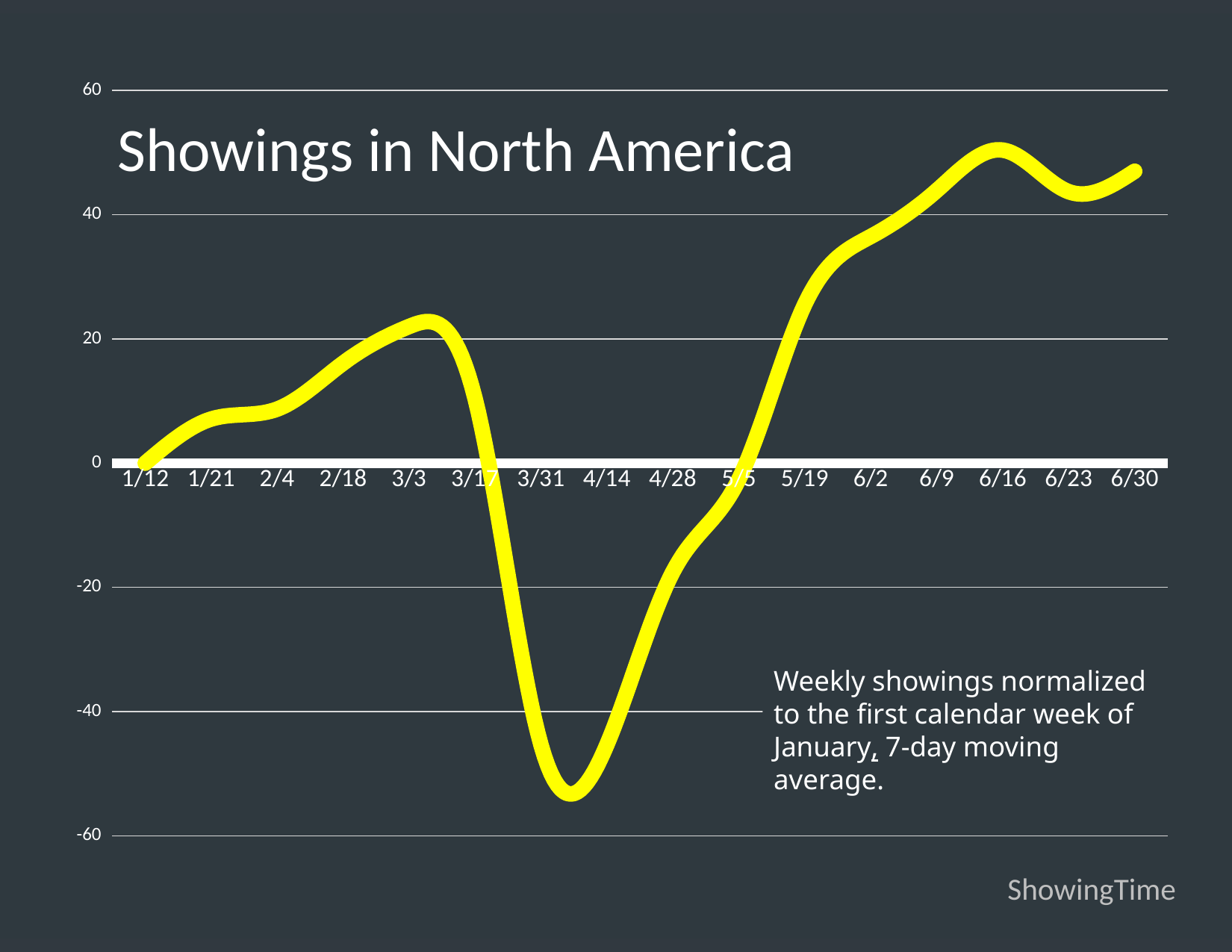
Near which labeled date does the line reach its highest point? 6/16 Is the value for 4/28 greater or less than 0? less How many dates are labeled on the x axis? 16 Between which two labeled dates does the line reach its lowest point? 3/31 and 4/14 Is the value for 2/4 greater or less than 20? less What kind of chart is shown on the slide? line chart Which has the larger value, 6/9 or 4/28? 6/9 Is the value for 5/19 greater or less than 0? greater What is the title of the chart? Showings in North America Does the line rise or fall between 3/3 and 4/14? fall